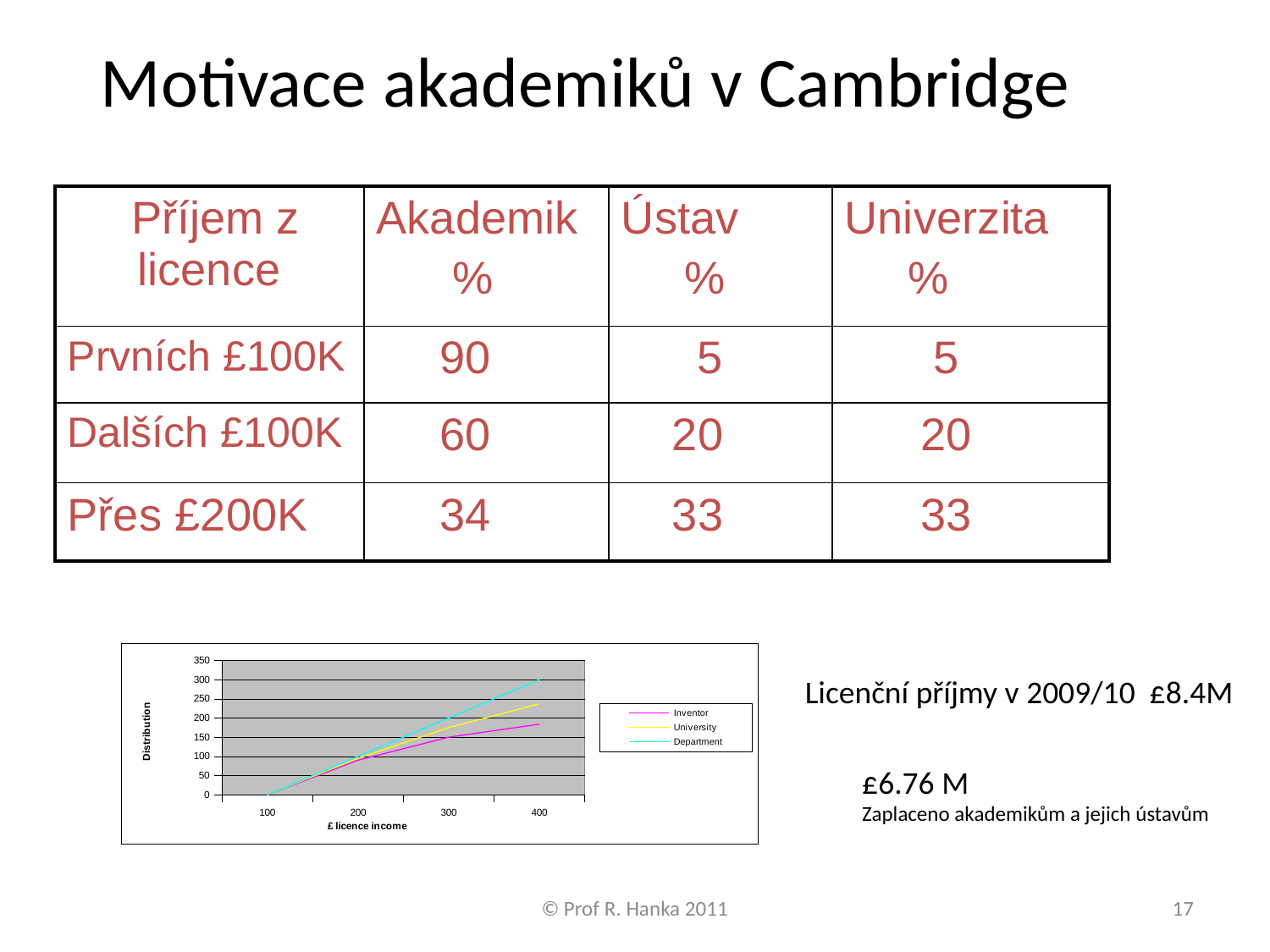
Which series has the lowest value at £ licence income of 400? Inventor Which series has the highest value at £ licence income of 400? Department Do the values of the Department series rise or fall as £ licence income increases? rise How many series does the chart's legend list? 3 At £ licence income of 400, is the Inventor value greater or less than 200? less How many labelled tick values are shown on the chart's x axis? 4 What are the three series named in the chart's legend? Inventor, University, Department What is the title of the chart's x axis? £ licence income At £ licence income of 400, which is larger: the Department value or the Inventor value? Department At £ licence income of 400, is the University value greater or less than 200? greater At £ licence income of 400, is the Department value greater or less than 250? greater What kind of chart is shown on the slide? line chart